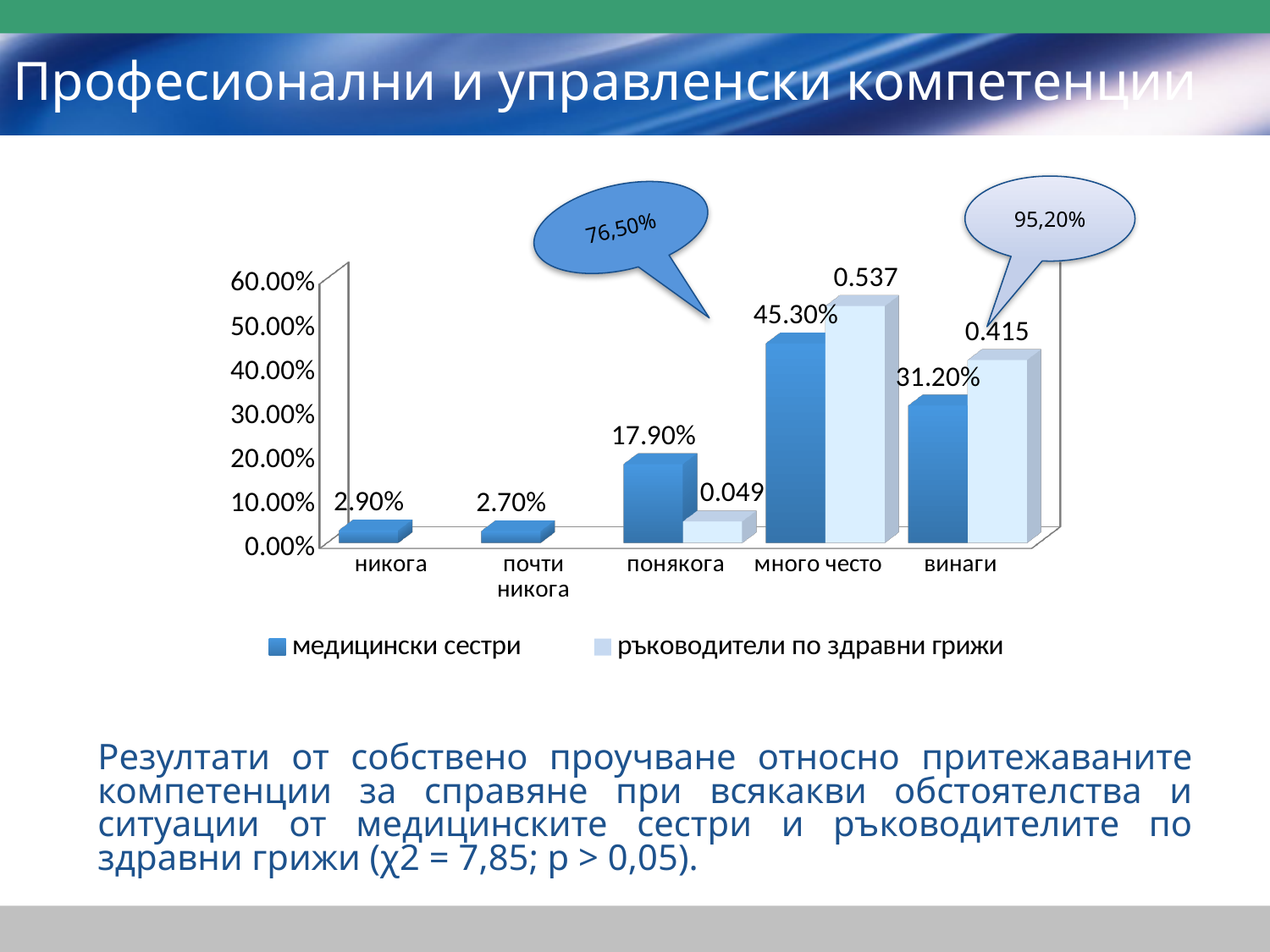
What kind of chart is shown on the slide? bar chart What is the value for ръководители по здравни грижи in the понякога category? 0.049 How many categories are shown on the x axis? 5 Which category has the highest value for медицински сестри? много често What is the value for ръководители по здравни грижи in the винаги category? 0.415 What is the value for медицински сестри in the много често category? 45.30% What is the value for медицински сестри in the понякога category? 17.90% Which is larger for the винаги category: the value for медицински сестри or for ръководители по здравни грижи? ръководители по здравни грижи Which category has the lowest value for медицински сестри? почти никога How many series does the legend list? 2 What value is shown in the callout pointing to the винаги bars? 95,20% What is the difference between the медицински сестри values for много често and винаги? 14.10%